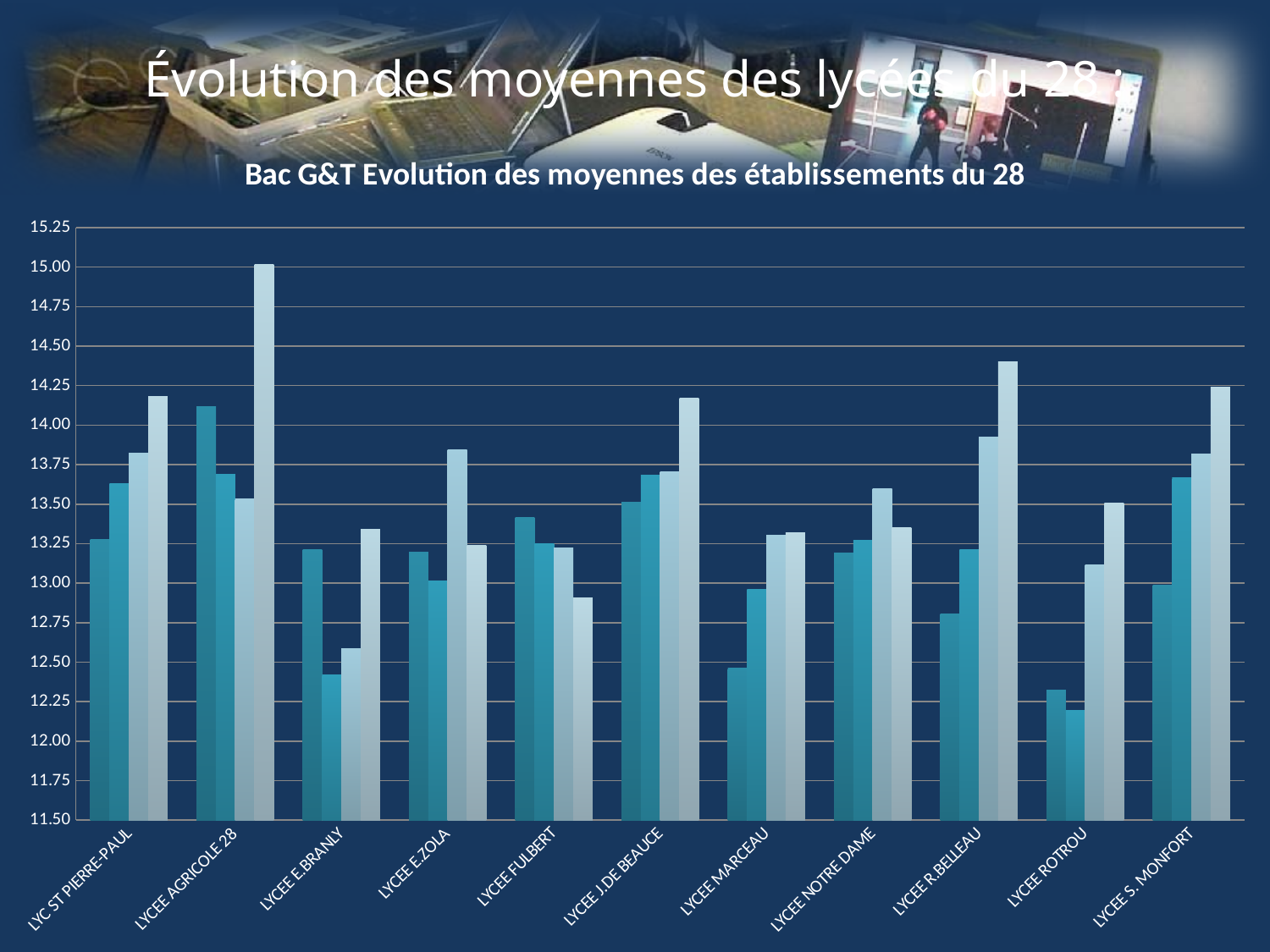
Is the shortest bar for LYCEE ROTROU greater or less than 12.50? less Is the tallest bar for LYCEE AGRICOLE 28 greater or less than 14.75? greater What is the title of the chart? Bac G&T Evolution des moyennes des établissements du 28 Which is taller: the rightmost bar for LYCEE AGRICOLE 28 or the rightmost bar for LYCEE R.BELLEAU? LYCEE AGRICOLE 28 Which lycée has the tallest bar in the chart? LYCEE AGRICOLE 28 How many lycées (categories) are shown on the x axis of the chart? 11 Which lycée has the shortest bar in the chart? LYCEE ROTROU Is the tallest bar for LYCEE R.BELLEAU greater or less than 14.25? greater Which is taller: the leftmost bar for LYCEE AGRICOLE 28 or the leftmost bar for LYCEE MARCEAU? LYCEE AGRICOLE 28 What kind of chart is shown on the slide? bar chart